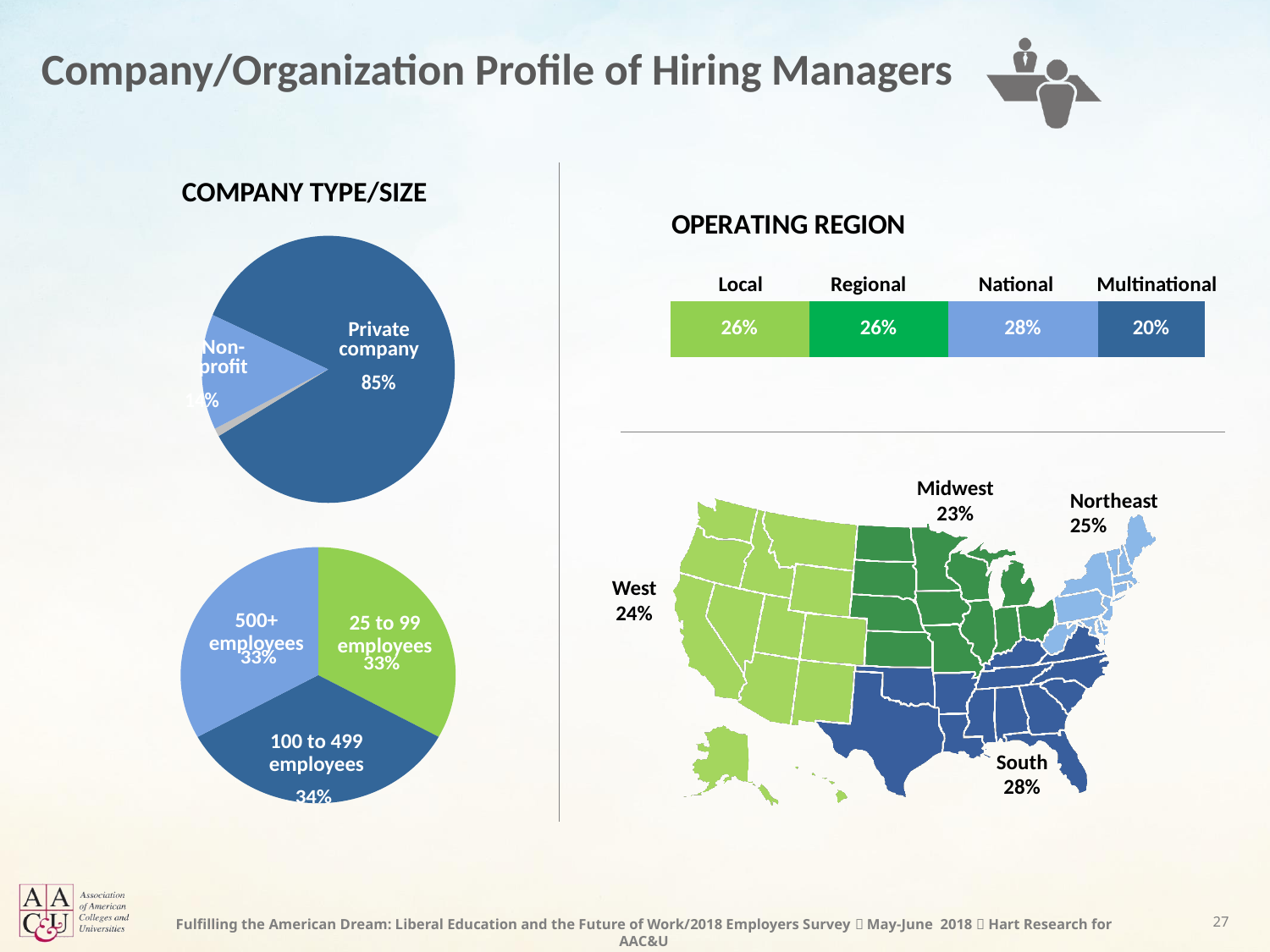
In the Operating Region bar, what is the difference between the National and Multinational percentages? 8 percentage points On the US map, is the percentage for the Northeast larger or smaller than the percentage for the West? larger In the Operating Region bar, how many region categories are shown? 4 In the bottom company size pie chart, what percentage of hiring managers are at companies with 500+ employees? 33% In the top company type pie chart, what share of hiring managers are from a private company? 85% In the Operating Region bar, which region category has the lowest percentage? Multinational In the top company type pie chart, which category has the largest slice? Private company In the bottom company size pie chart, how many company size categories are shown? 3 On the US map, which region has the lowest percentage? Midwest In the bottom company size pie chart, what percentage of hiring managers are at companies with 100 to 499 employees? 34% On the US map, what percentage of hiring managers are in the South? 28% In the Operating Region bar, what percentage of hiring managers are at national companies? 28%